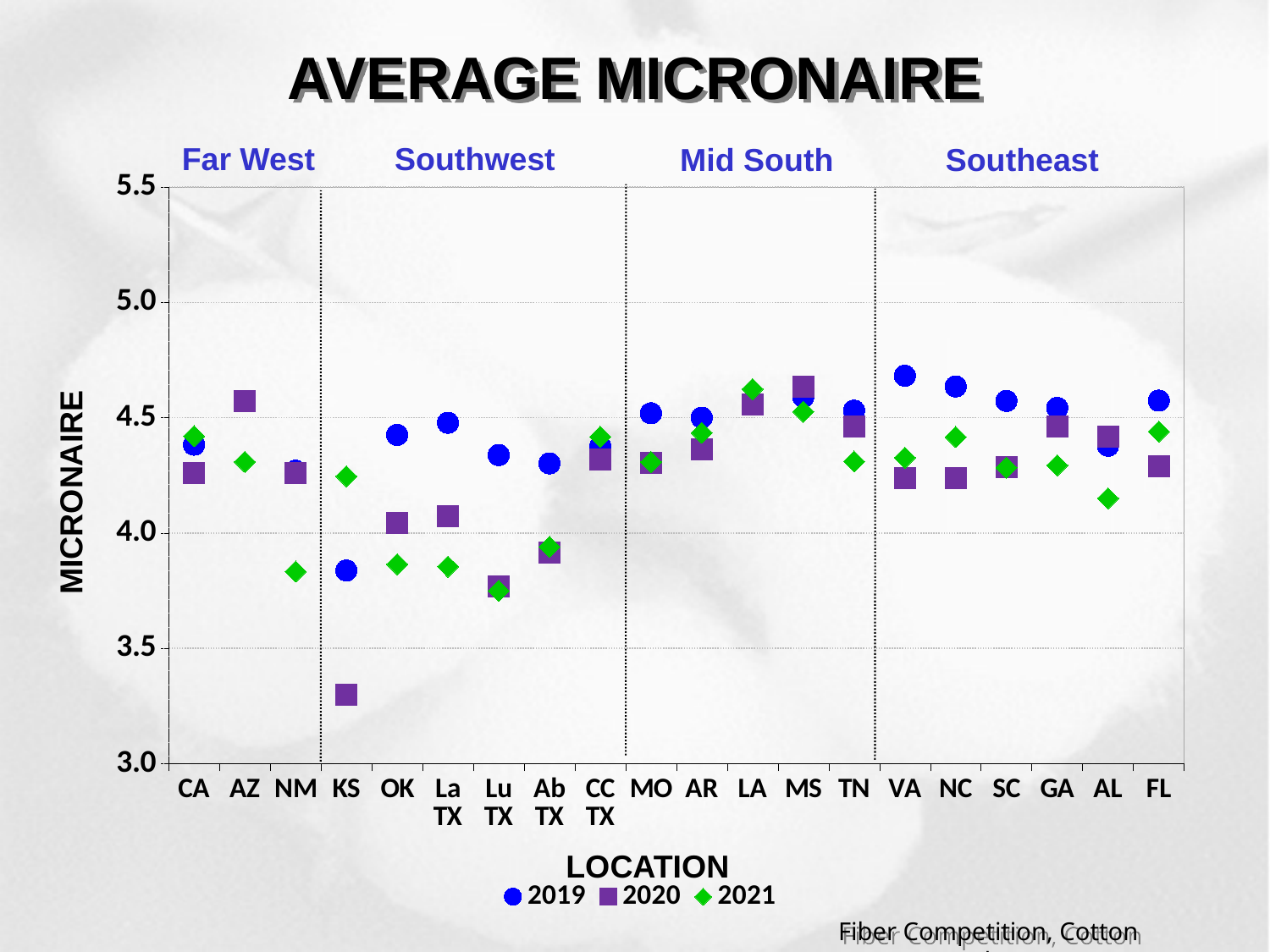
Which location has the lowest 2020 micronaire value? KS What kind of chart is shown on the slide? Scatter (dot) chart Is the 2020 value for KS greater or less than 3.5? less How many locations are plotted along the x axis? 20 What is the title of the y axis? MICRONAIRE Is the 2019 value for VA greater or less than 4.5? greater For KS, which is larger, the 2019 value or the 2020 value? 2019 Which location has the lowest 2021 micronaire value? Lu TX Is the 2021 value for AL greater or less than 4.5? less Which location has the lowest 2019 micronaire value? KS How many series does the legend list? 3